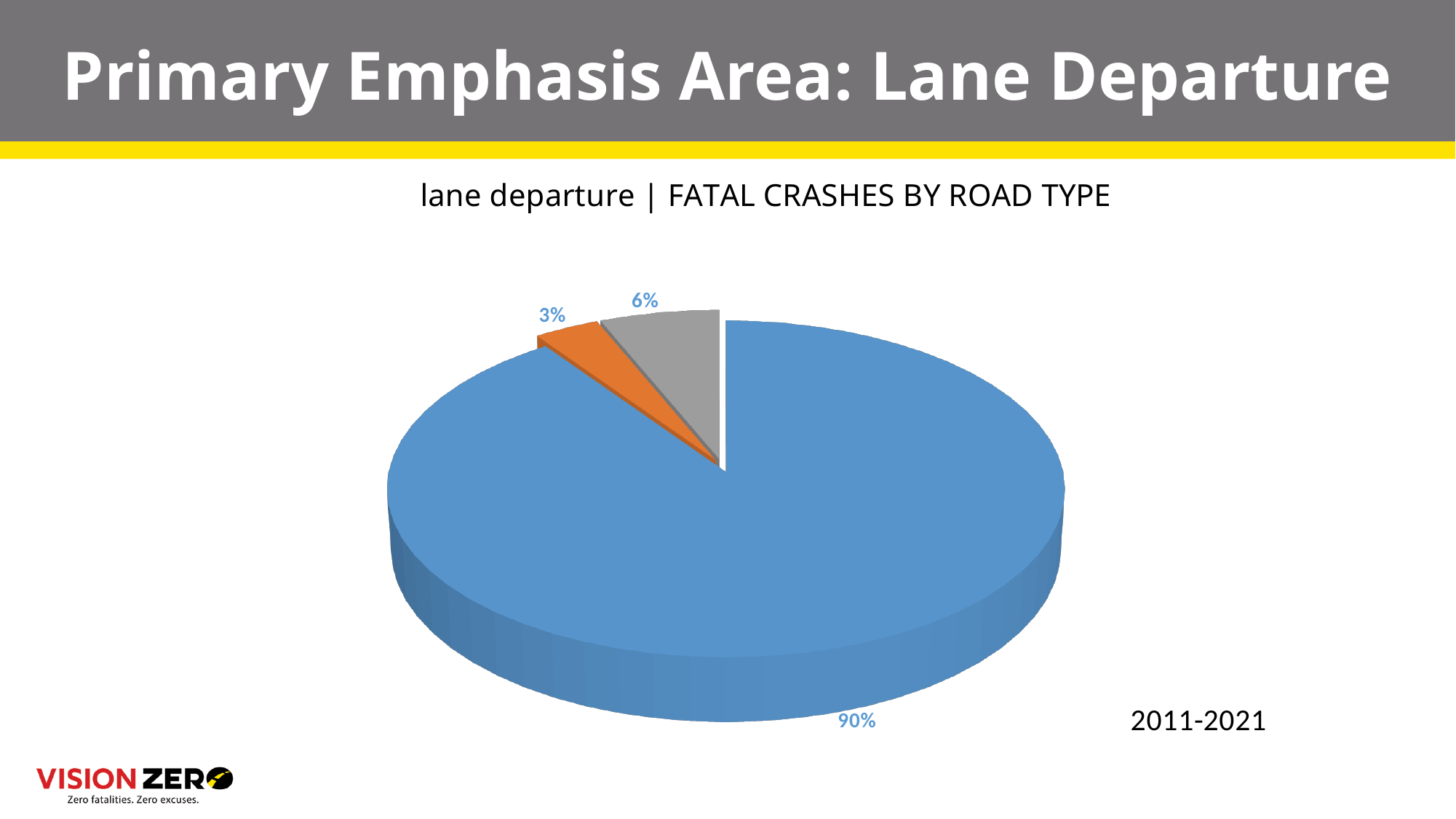
What time period is noted on the slide for the chart data? 2011-2021 Which slice is larger, the gray slice or the orange slice? gray How many slices does the pie chart have? 3 What percentage is shown for the orange slice of the pie chart? 3% What is the difference in percentage points between the blue slice and the gray slice? 84 What kind of chart is shown on the slide? pie chart What percentage is shown for the blue slice of the pie chart? 90% What percentage is shown for the gray slice of the pie chart? 6% Which colour slice represents the smallest share of the pie chart? orange Which colour slice represents the largest share of the pie chart? blue What is the title of the chart? lane departure | FATAL CRASHES BY ROAD TYPE What is the difference in percentage points between the gray slice and the orange slice? 3